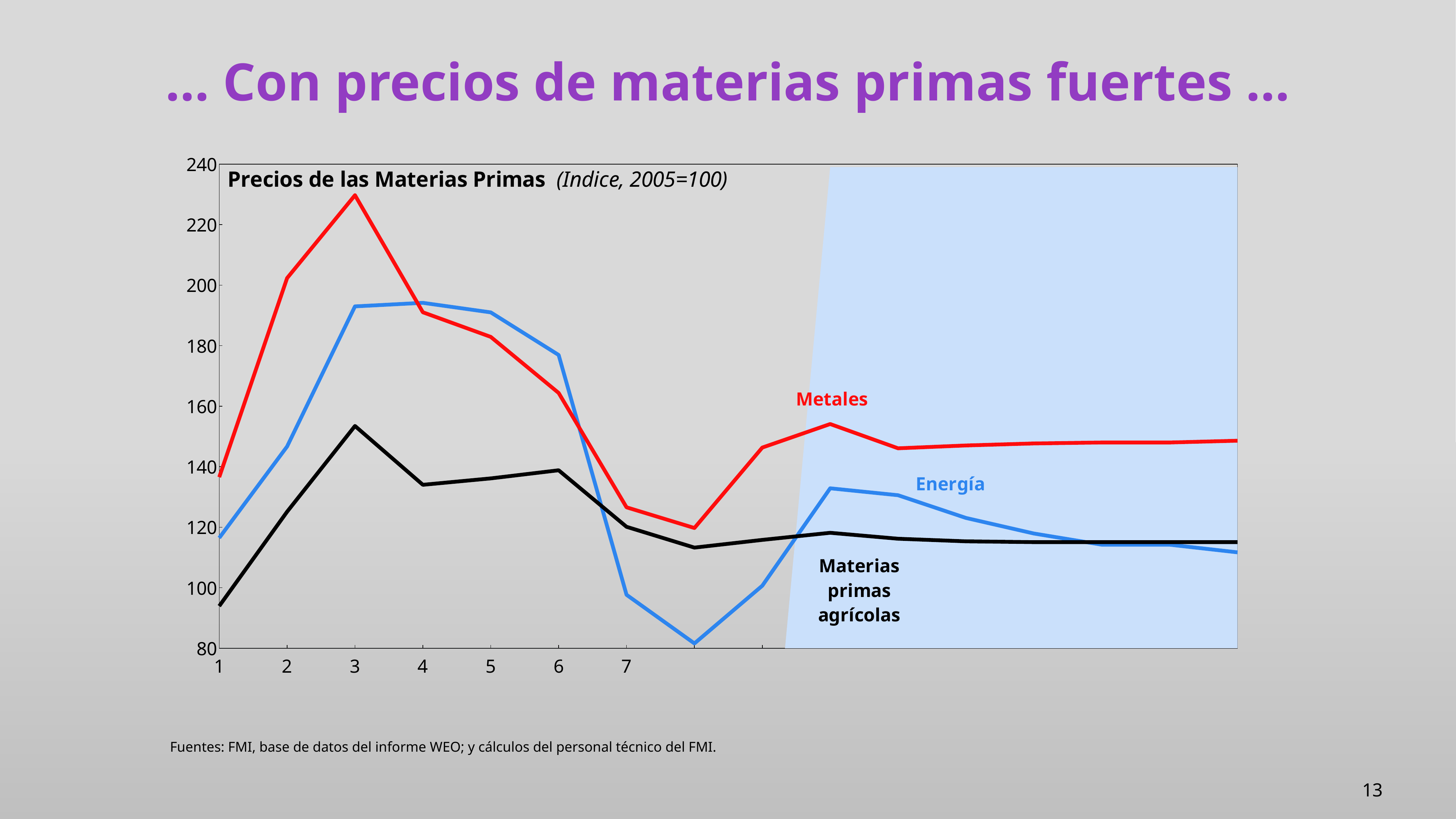
At x = 7, which is larger: Metales or Energía? Metales Which series is drawn in red? Metales Which series has the lowest value at x = 1? Materias primas agrícolas Is the value for Materias primas agrícolas at x = 1 greater or less than 100? less Is the value for Energía at x = 3 greater or less than 180? greater Is the value for Metales at x = 3 greater or less than 220? greater How many series are labelled on the chart? 3 Which series has the highest value at x = 3? Metales What is the title of the chart? Precios de las Materias Primas What kind of chart is shown on the slide? line chart Does the Metales series rise or fall between x = 3 and x = 7? fall